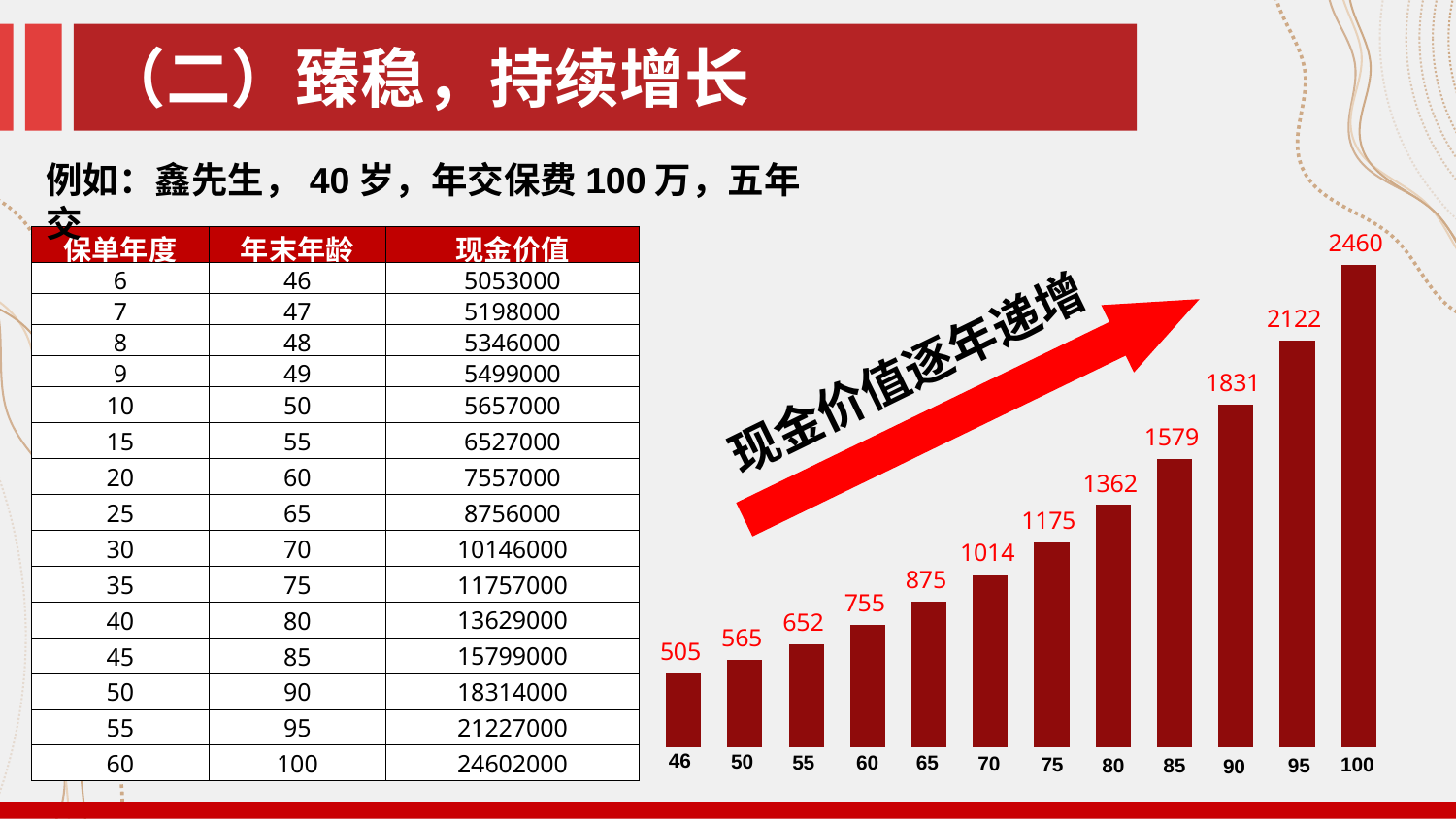
Do the values rise or fall as age increases along the x axis? rise Which age category has the lowest bar? 46 Which age category has the highest bar? 100 What is the data label on the bar for age 90? 1831 Which is larger, the value for age 65 or the value for age 75? 75 What is the data label on the bar for age 46? 505 How many bars are shown in the chart? 12 What text is written on the red arrow above the bars? 现金价值逐年递增 What is the difference between the values for age 100 and age 95? 338 What type of chart is shown on the slide? bar chart What is the difference between the values for age 60 and age 50? 190 What is the data label on the bar for age 70? 1014